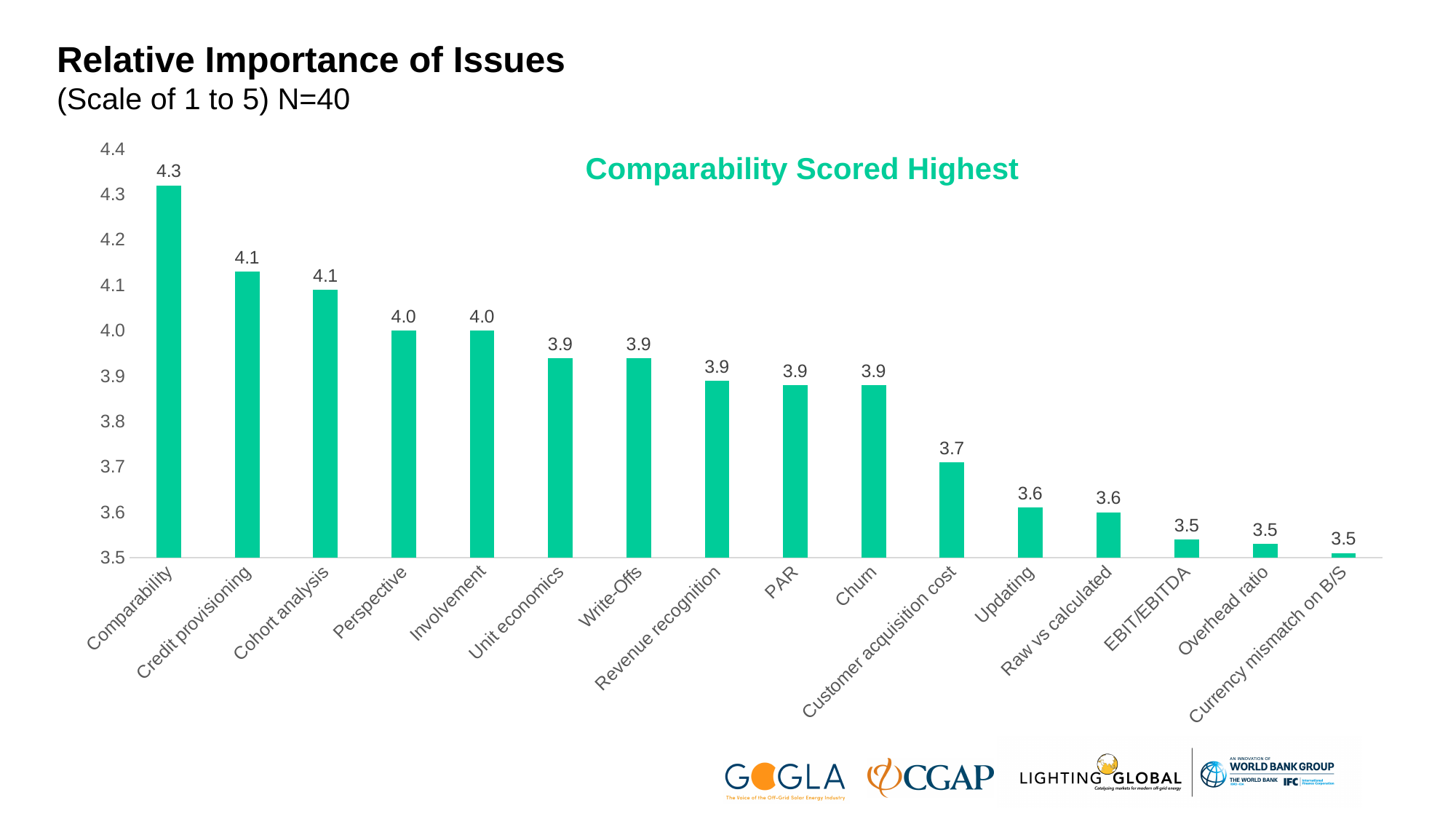
What kind of chart is shown on the slide? bar chart What is the value for Perspective? 4.0 Is the value for Customer acquisition cost greater or less than 4.0? less Which is larger, the value for Perspective or the value for Updating? Perspective How many categories are shown on the x axis? 16 What is the title of the chart? Relative Importance of Issues Which category has the highest value? Comparability What is the value for Customer acquisition cost? 3.7 What is the difference between the values for Comparability and Customer acquisition cost? 0.6 What is the value for Updating? 3.6 Do the values rise or fall from left to right along the x axis? fall What is the value for Comparability? 4.3